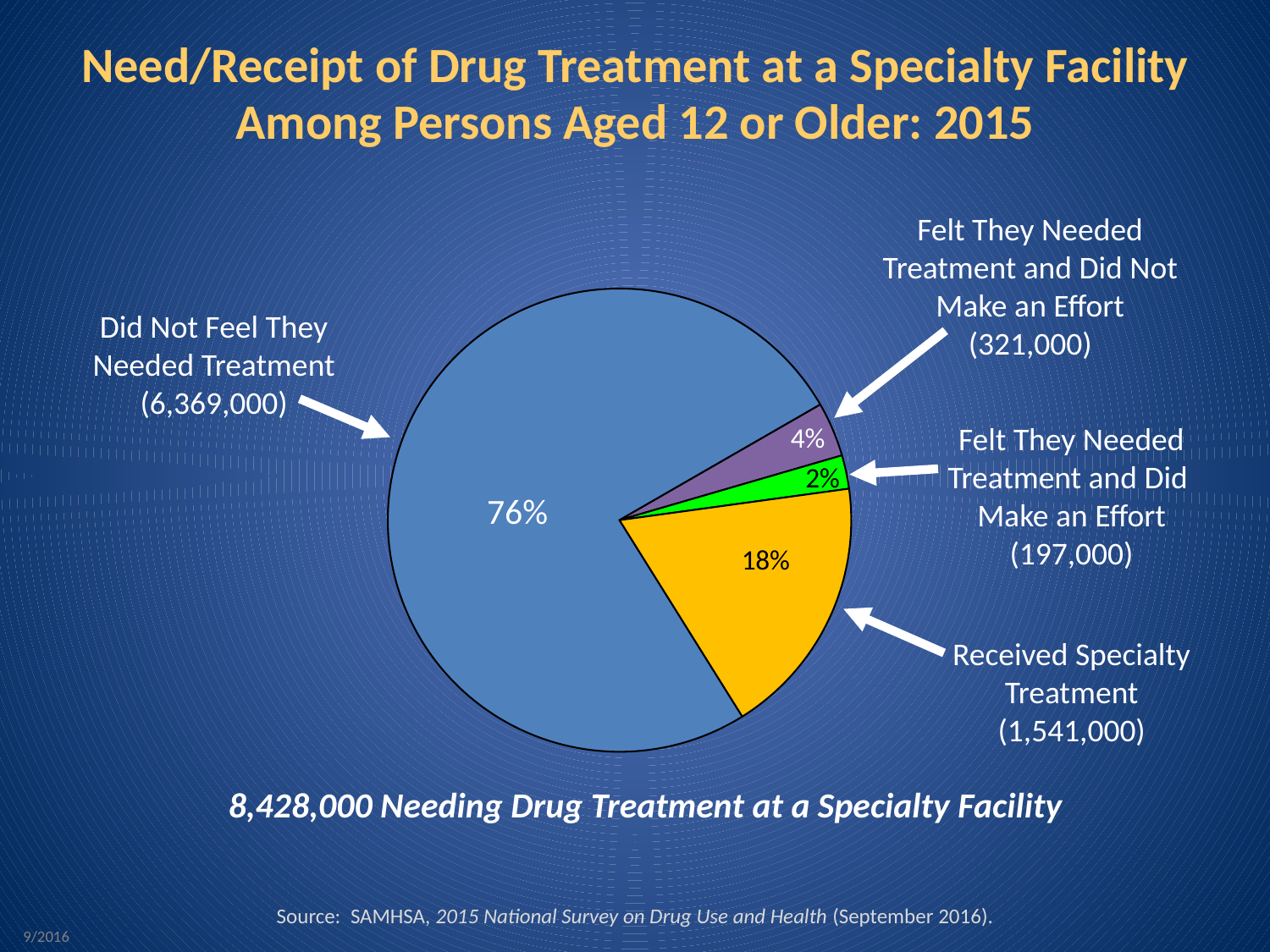
Which category has the largest slice of the pie? Did Not Feel They Needed Treatment What total number of persons needing drug treatment at a specialty facility is stated below the chart? 8,428,000 How many people are shown for 'Received Specialty Treatment'? 1,541,000 How many slices does the pie chart have? 4 What is the difference in percentage points between the 'Did Not Feel They Needed Treatment' slice and the 'Received Specialty Treatment' slice? 58 percentage points What percentage of the pie is labelled for 'Received Specialty Treatment'? 18% What percentage of the pie is labelled for 'Felt They Needed Treatment and Did Make an Effort'? 2% What percentage of the pie is labelled for 'Felt They Needed Treatment and Did Not Make an Effort'? 4% Which category has the smallest slice of the pie? Felt They Needed Treatment and Did Make an Effort What type of chart is shown on the slide? pie chart How many people are shown for 'Did Not Feel They Needed Treatment'? 6,369,000 What percentage of the pie is labelled for 'Did Not Feel They Needed Treatment'? 76%